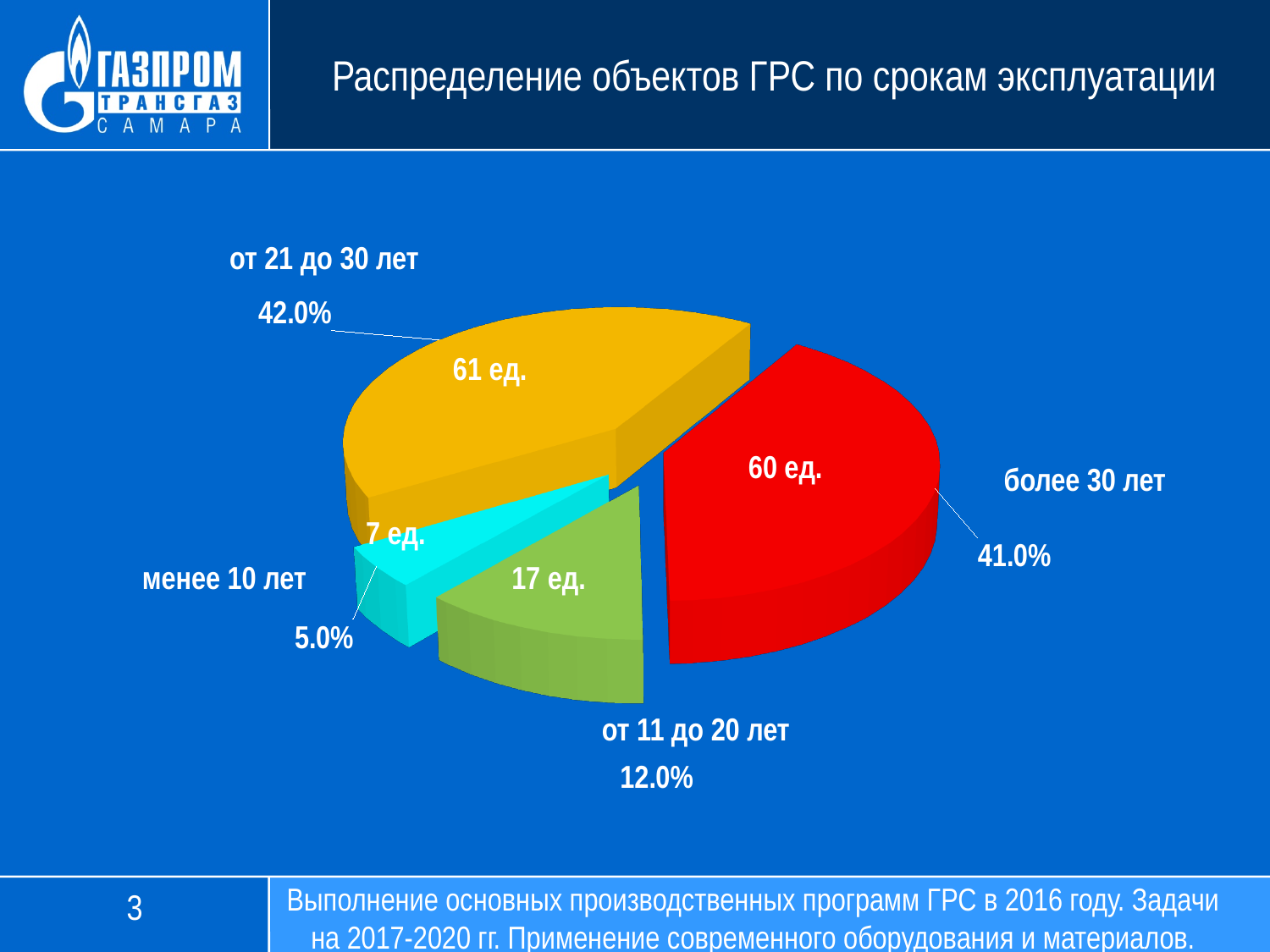
What is the title of the chart on the slide? Распределение объектов ГРС по срокам эксплуатации Which category has the largest share of the pie? от 21 до 30 лет What type of chart is shown on the slide? pie chart Which category has more units: 'от 11 до 20 лет' or 'менее 10 лет'? от 11 до 20 лет What percentage share is shown for the category 'более 30 лет'? 41.0% Which category has the smallest share of the pie? менее 10 лет What percentage share is shown for the category 'от 11 до 20 лет'? 12.0% What is the number of units (ед.) for the category 'менее 10 лет'? 7 ед. What is the difference in units between 'от 21 до 30 лет' and 'более 30 лет'? 1 ед. How many slices does the pie chart have? 4 What is the number of units (ед.) for the category 'от 21 до 30 лет'? 61 ед. What is the total number of units across all four categories? 145 ед.